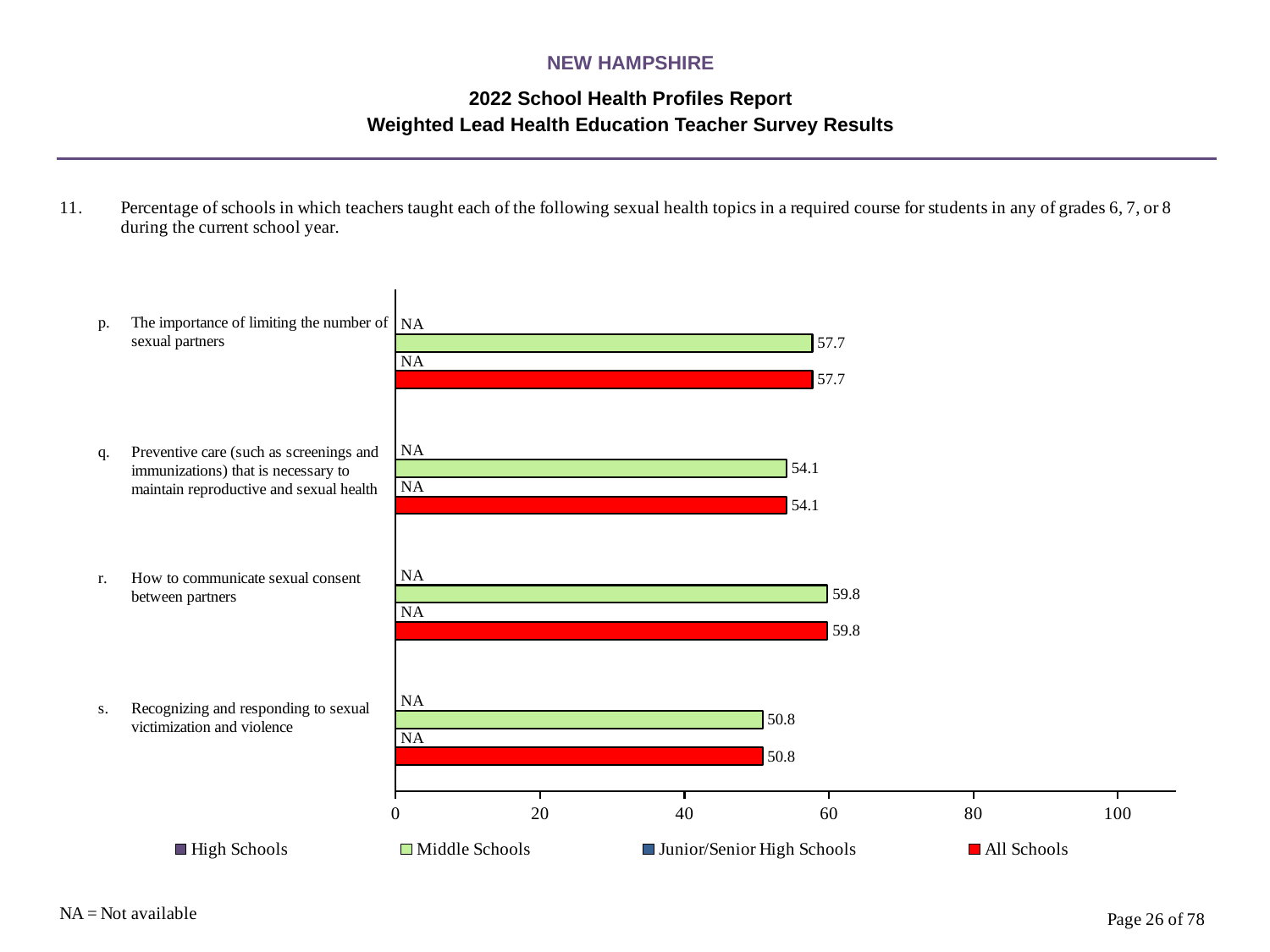
What is the Middle Schools value for 'Preventive care (such as screenings and immunizations) that is necessary to maintain reproductive and sexual health'? 54.1 How many topics are listed on the chart? 4 What is the difference between the Middle Schools values for 'How to communicate sexual consent between partners' and 'Recognizing and responding to sexual victimization and violence'? 9.0 What kind of chart is shown? bar chart Which topic has the lowest All Schools value? Recognizing and responding to sexual victimization and violence How many series does the legend list? 4 What is the Middle Schools value for 'How to communicate sexual consent between partners'? 59.8 Which is larger: the All Schools value for 'The importance of limiting the number of sexual partners' or for 'Preventive care (such as screenings and immunizations) that is necessary to maintain reproductive and sexual health'? The importance of limiting the number of sexual partners Which topic has the highest Middle Schools value? How to communicate sexual consent between partners What is the All Schools value for 'Recognizing and responding to sexual victimization and violence'? 50.8 Is the Middle Schools value for 'Recognizing and responding to sexual victimization and violence' greater or less than 60? less What is shown for High Schools for 'The importance of limiting the number of sexual partners'? NA